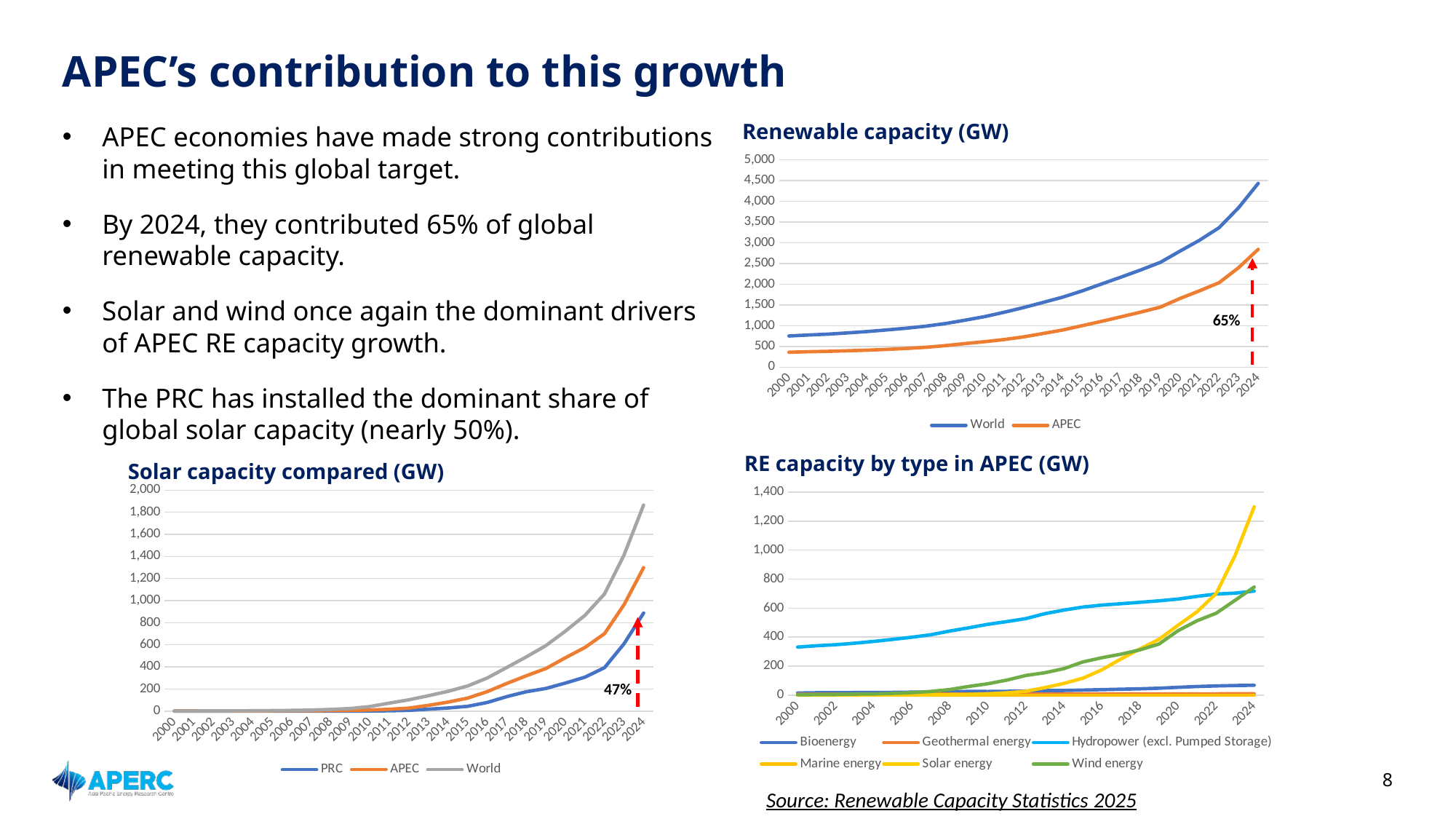
How many series does the legend of the 'Renewable capacity (GW)' chart list? 2 In the 'RE capacity by type in APEC (GW)' chart, which series has the highest value in 2024? Solar energy What percentage is annotated next to the 2024 point in the 'Renewable capacity (GW)' chart? 65% In the 'Solar capacity compared (GW)' chart, which is larger in 2024, PRC or APEC? APEC What type of chart is the 'Renewable capacity (GW)' chart? line chart How many series does the legend of the 'Solar capacity compared (GW)' chart list? 3 In the 'Renewable capacity (GW)' chart, is the APEC value for 2024 greater or less than 3,000? less How many series does the legend of the 'RE capacity by type in APEC (GW)' chart list? 6 In the 'Solar capacity compared (GW)' chart, which series has the highest value in 2024? World In the 'Renewable capacity (GW)' chart, is the World value for 2024 greater or less than 4,000? greater In the 'Solar capacity compared (GW)' chart, is the World value for 2024 greater or less than 1,800? greater In the 'Renewable capacity (GW)' chart, does the World series rise or fall from 2000 to 2024? rise